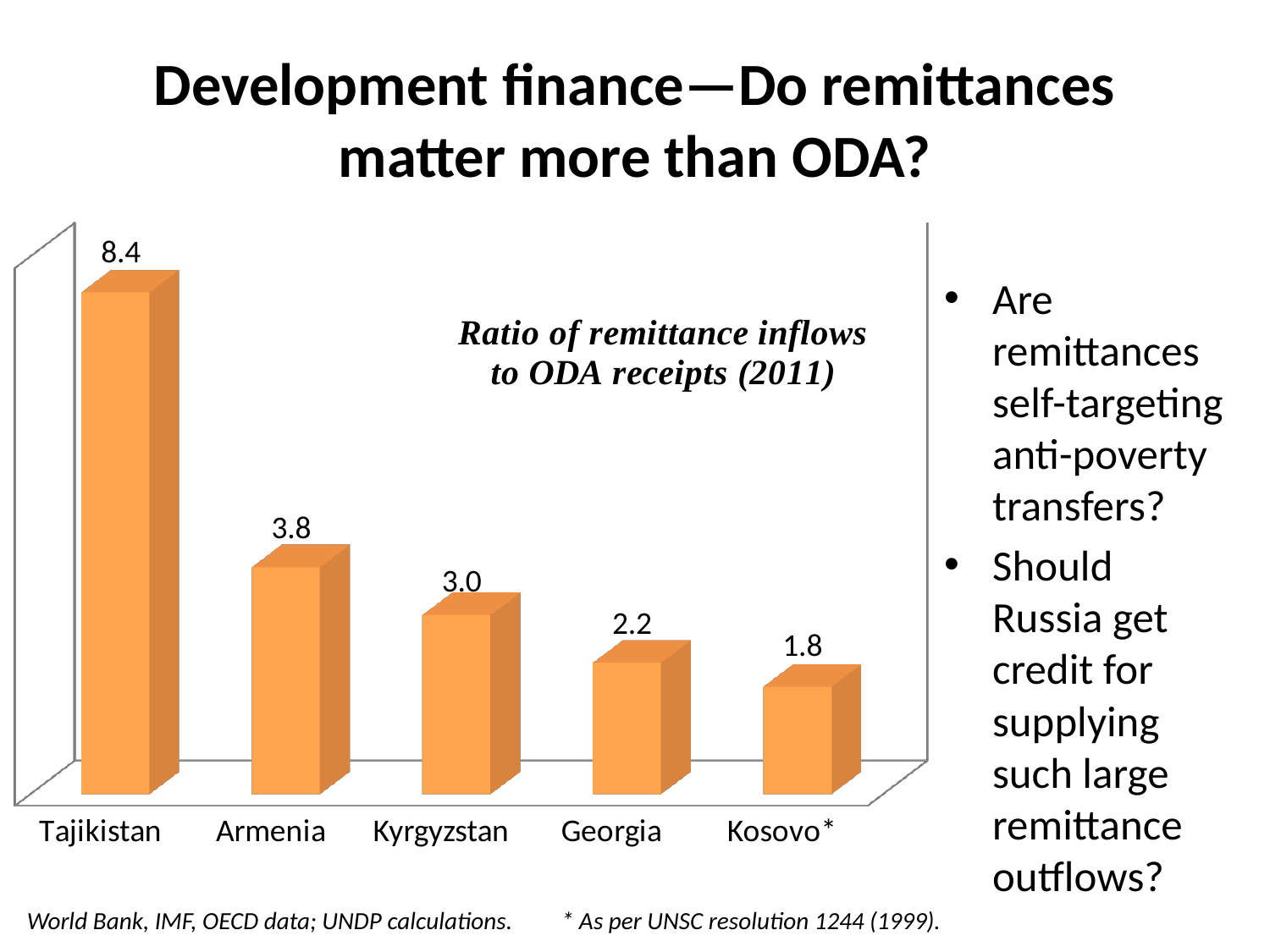
What is the value shown for Georgia? 2.2 What is the value shown for Kyrgyzstan? 3.0 What is the difference between the values for Tajikistan and Armenia? 4.6 What is the title of the chart? Ratio of remittance inflows to ODA receipts (2011) What is the ratio of remittance inflows to ODA receipts for Tajikistan? 8.4 Which has a larger value, Kyrgyzstan or Georgia? Kyrgyzstan Which country has the highest ratio of remittance inflows to ODA receipts? Tajikistan What is the value shown for Kosovo*? 1.8 How many countries are shown in the chart? 5 What kind of chart is shown on the slide? Bar chart What is the value shown for Armenia? 3.8 Which country has the lowest ratio of remittance inflows to ODA receipts? Kosovo*